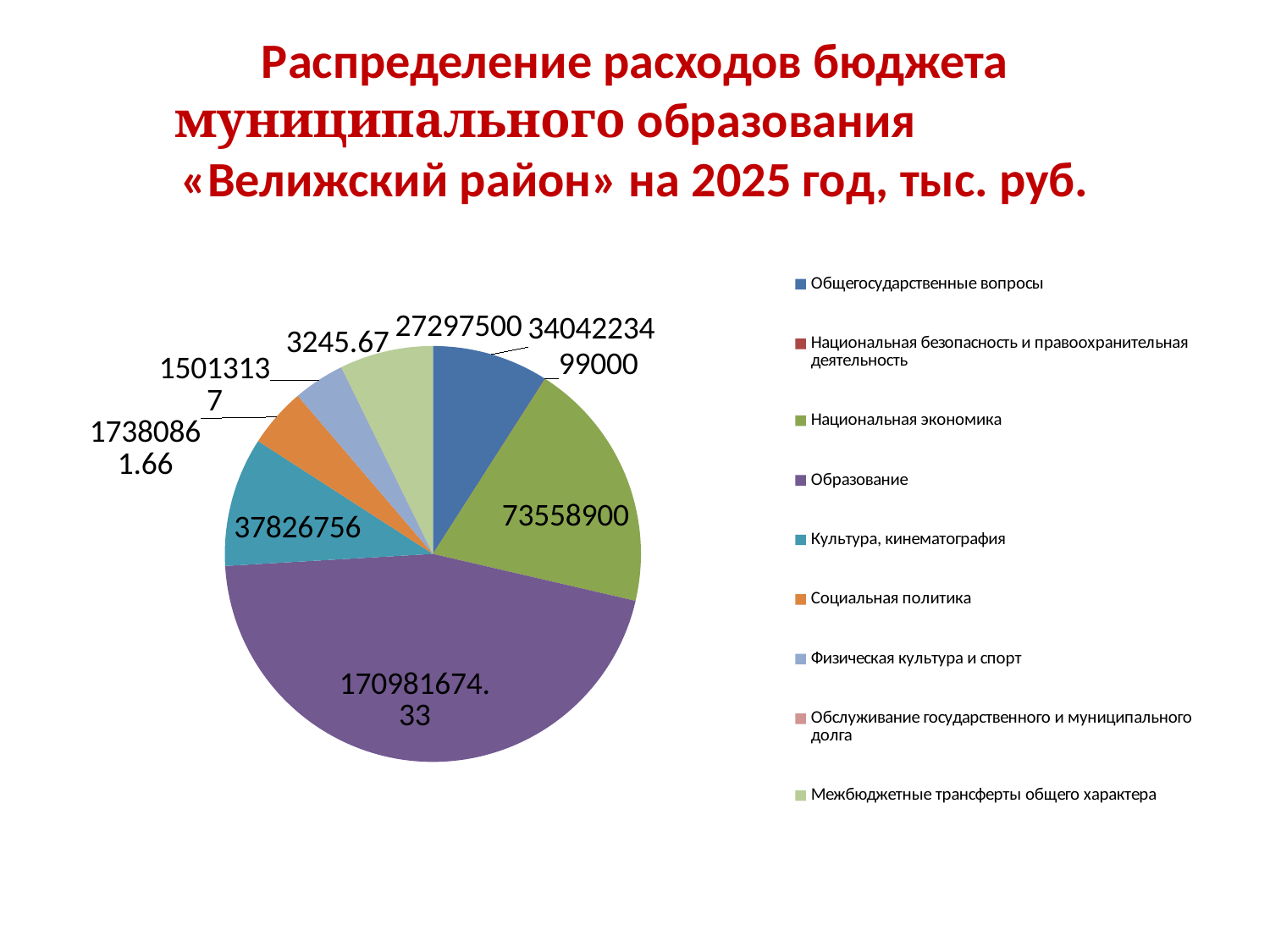
Which category has the largest share of the budget expenditures? Образование What type of chart is shown on the slide? Pie chart What is the value for Образование in the pie chart? 170981674.33 How many expenditure categories does the legend list? 9 What is the value for Национальная экономика? 73558900 What is the value for Общегосударственные вопросы? 34042234 What is the value for Национальная безопасность и правоохранительная деятельность? 99000 Which category has the smallest value in the chart? Обслуживание государственного и муниципального долга Which is larger: Национальная экономика or Культура, кинематография? Национальная экономика What is the difference between Национальная экономика and Культура, кинематография? 35732144 What is the value for Межбюджетные трансферты общего характера? 27297500 What is the value for Культура, кинематография? 37826756